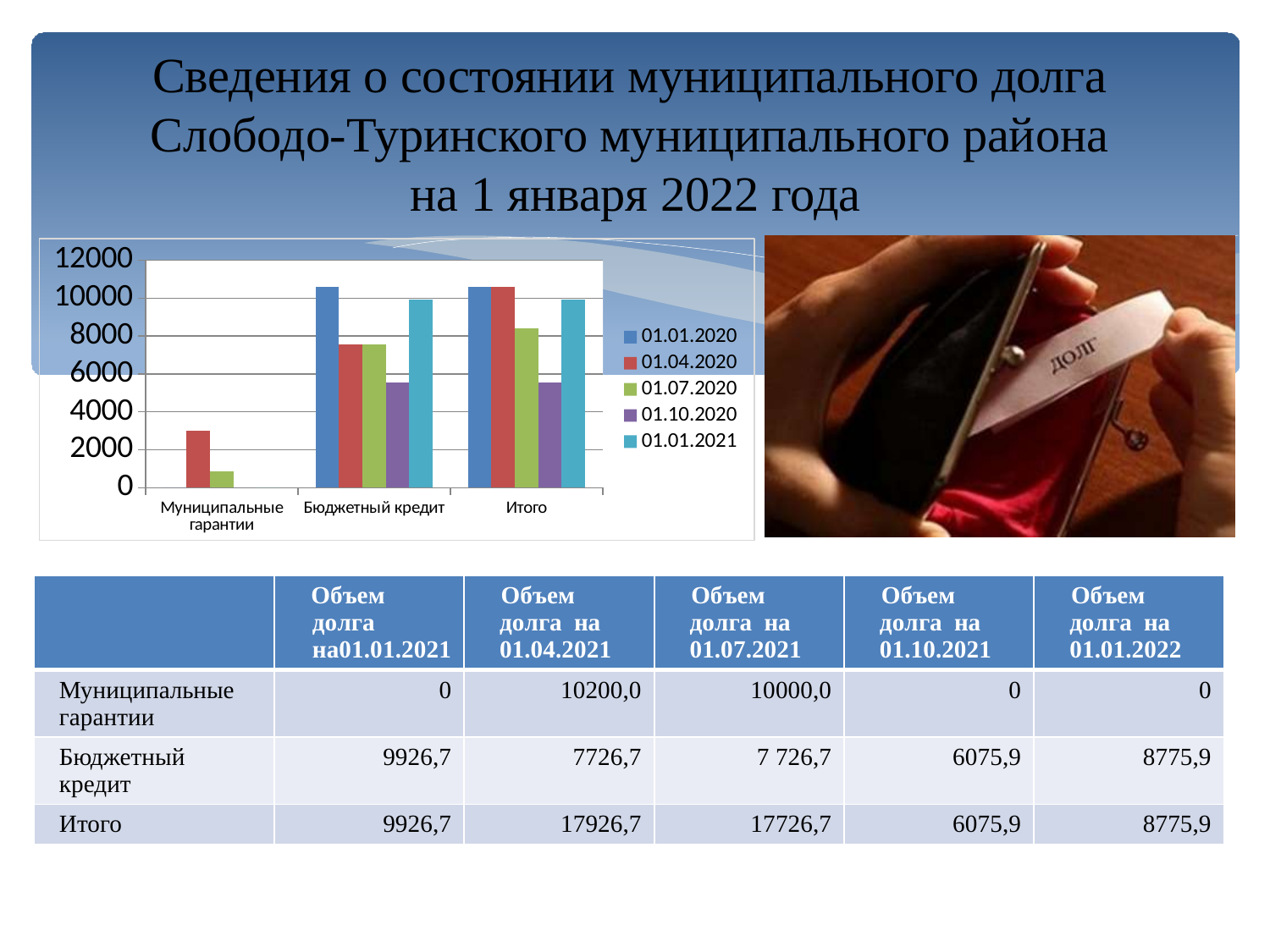
What kind of chart is shown on the slide? bar chart Is the value for Бюджетный кредит in the 01.01.2020 series greater or less than 10000? greater For Бюджетный кредит, which is larger: the 01.01.2020 value or the 01.10.2020 value? 01.01.2020 Is the value for Итого in the 01.01.2021 series greater or less than 8000? greater For Муниципальные гарантии, which is larger: the 01.04.2020 value or the 01.07.2020 value? 01.04.2020 For Бюджетный кредит, which series has the lowest value? 01.10.2020 Is the value for Бюджетный кредит in the 01.10.2020 series greater or less than 6000? less What is the first entry listed in the chart legend? 01.01.2020 How many categories are shown on the x axis of the chart? 3 For Муниципальные гарантии, which series has the highest value? 01.04.2020 How many series does the chart legend list? 5